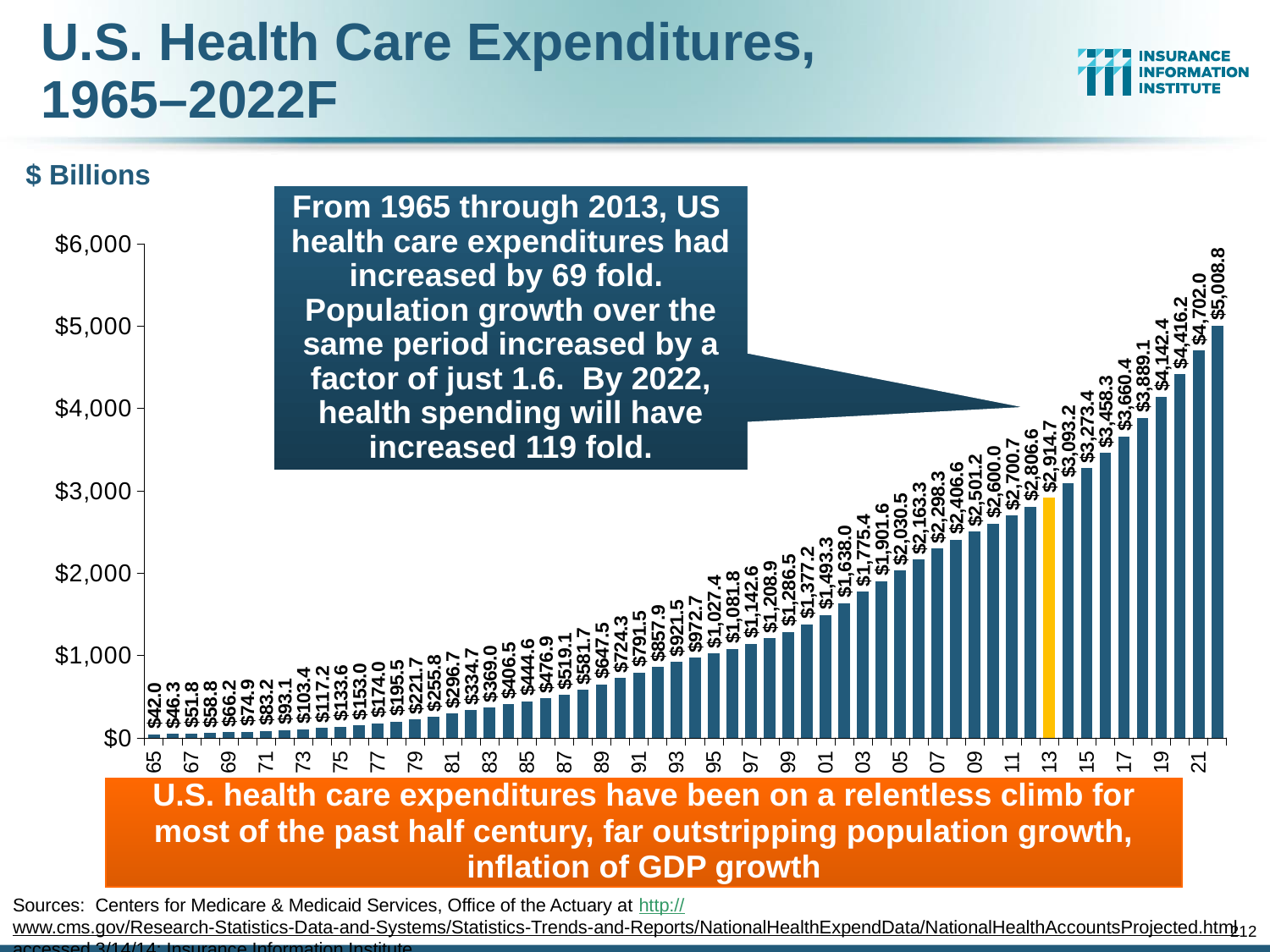
What type of chart is shown on the slide? Bar chart What colour is the bar for 2013, which differs from the other bars? Yellow What value does the chart show for the year 2000? $1,377.2 What value is shown for the highlighted 2013 bar? $2,914.7 Which is larger, the value for 1995 or the value for 2005? 2005 Which year has the highest value on the chart? 2022 Do the values generally rise or fall from 1965 to 2022? Rise Is the value for 2017 greater or less than $3,000? greater What is the difference between the 2022 value and the 2013 value? $2,094.1 What is the forecast value for 2022 on the chart? $5,008.8 Which year has the lowest value on the chart? 1965 What was U.S. health care expenditure in 1965 according to the chart? $42.0